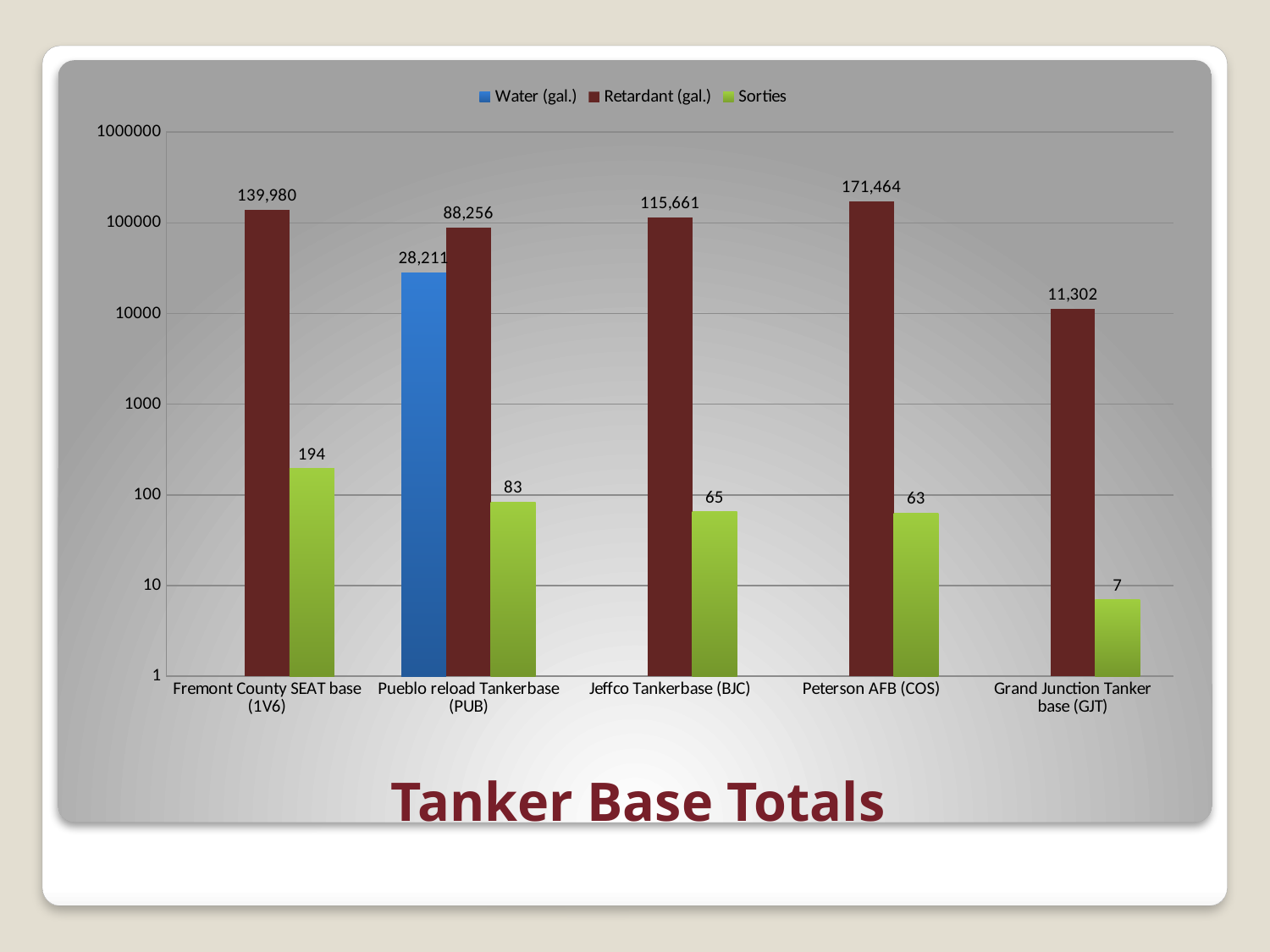
Which tanker base has the lowest number of Sorties? Grand Junction Tanker base (GJT) What kind of chart is shown on the slide? Bar chart What is the difference in Retardant (gal.) between Fremont County SEAT base (1V6) and Jeffco Tankerbase (BJC)? 24,319 How many series does the legend list? 3 Which tanker base has the highest Retardant (gal.) value? Peterson AFB (COS) Which tanker base is the only one with a Water (gal.) bar? Pueblo reload Tankerbase (PUB) What is the Retardant (gal.) value for Grand Junction Tanker base (GJT)? 11,302 What is the Water (gal.) value for Pueblo reload Tankerbase (PUB)? 28,211 How many tanker bases are shown on the x axis? 5 How many Sorties are shown for Fremont County SEAT base (1V6)? 194 Which has more Sorties, Pueblo reload Tankerbase (PUB) or Jeffco Tankerbase (BJC)? Pueblo reload Tankerbase (PUB) What is the Retardant (gal.) value for Peterson AFB (COS)? 171,464